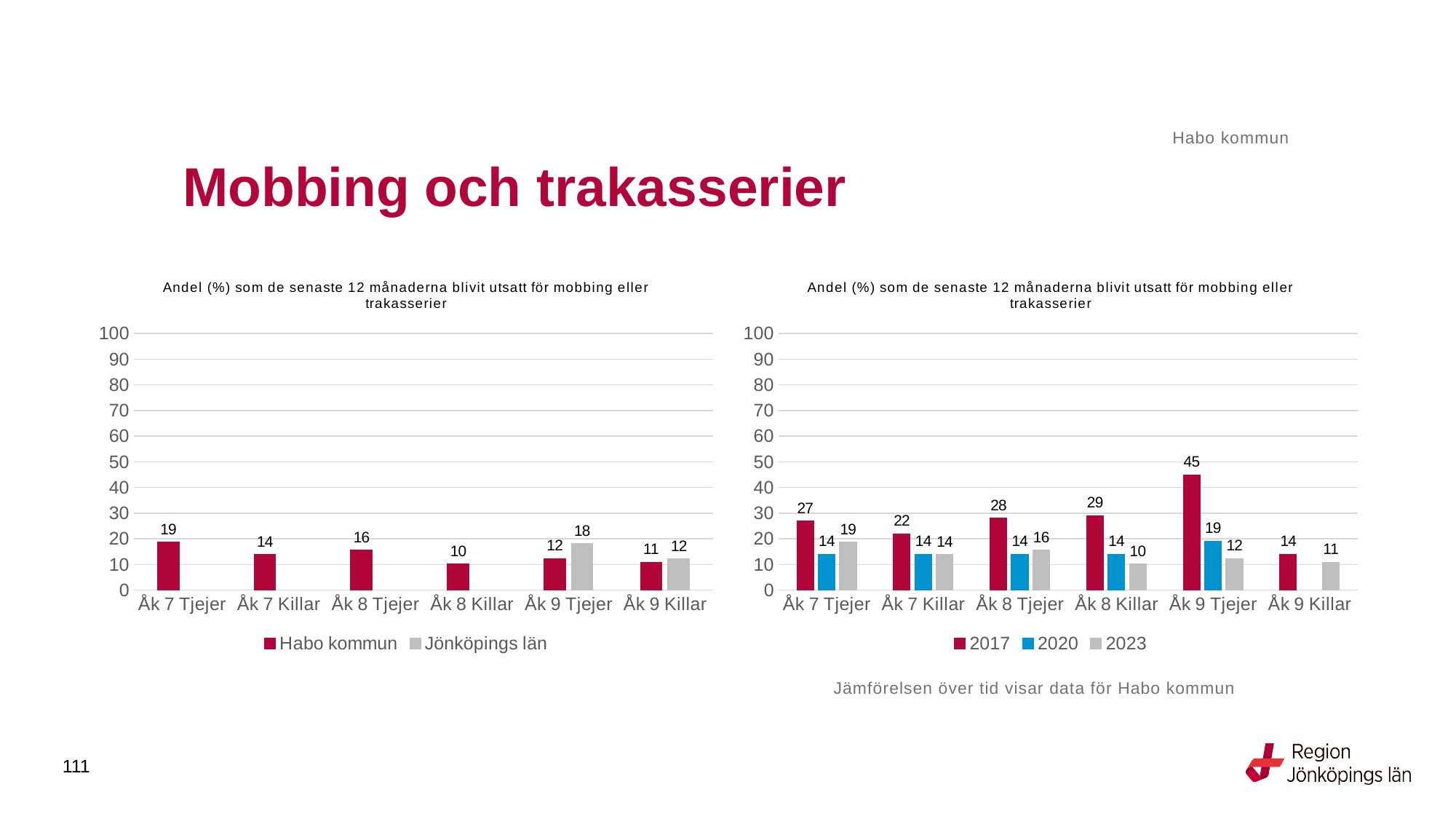
In the right chart, what is the difference between 2017 and 2023 for Åk 9 Tjejer? 33 In the left chart, what is the value for Jönköpings län for Åk 9 Tjejer? 18 What kind of chart is the right chart? Bar chart In the left chart, how many series does the legend list? 2 In the right chart, what is the value for 2023 for Åk 8 Killar? 10 In the left chart, what is the difference between Jönköpings län and Habo kommun for Åk 9 Tjejer? 6 In the right chart, how many series does the legend list? 3 In the left chart, what is the value for Habo kommun for Åk 7 Tjejer? 19 In the right chart, which category has the highest value for 2017? Åk 9 Tjejer In the right chart, which is larger for Åk 8 Tjejer: the 2017 value or the 2020 value? 2017 In the left chart, which category has the lowest value for Habo kommun? Åk 8 Killar In the right chart, what is the value for 2017 for Åk 9 Tjejer? 45